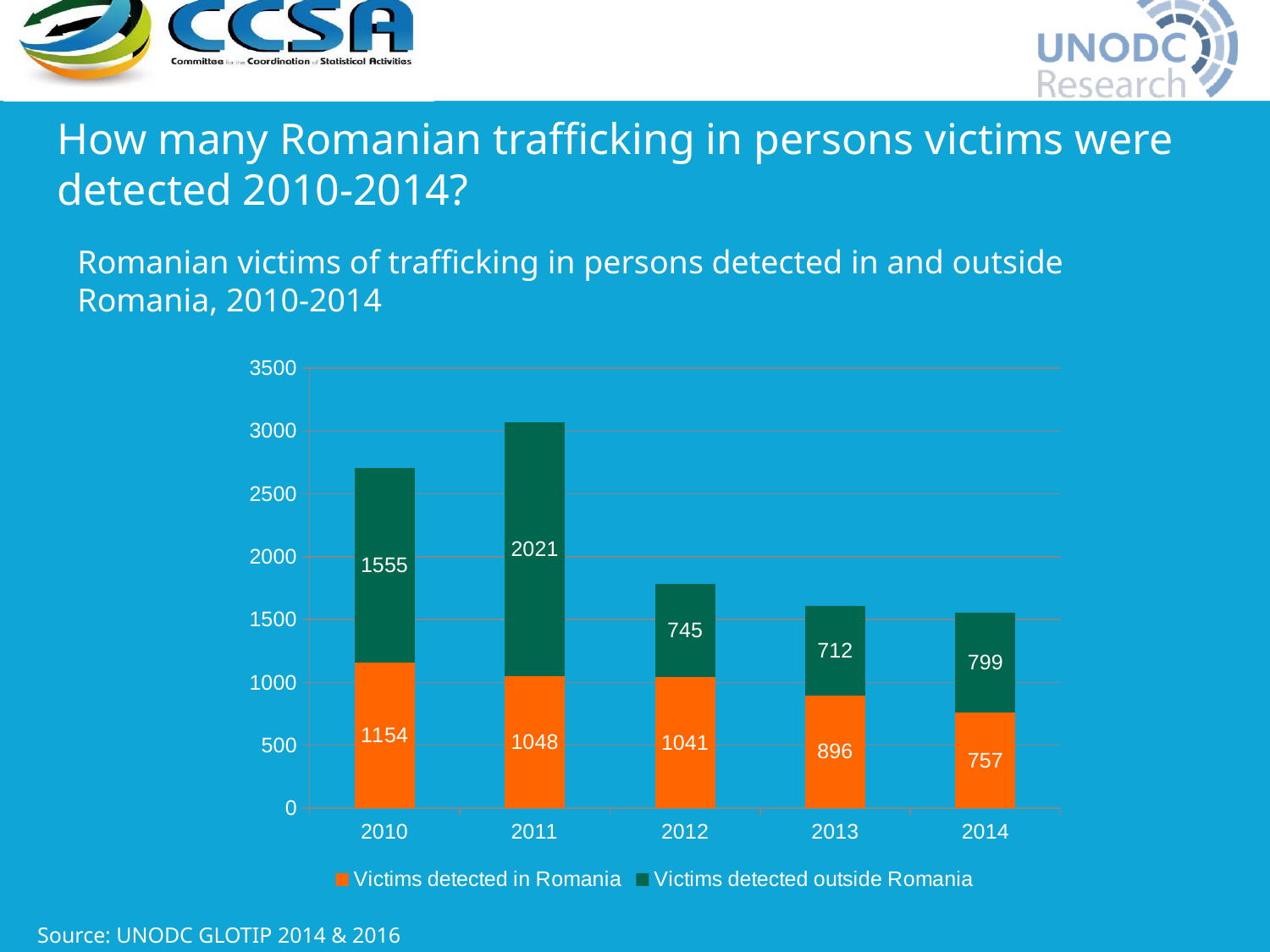
Which year has the highest number of victims detected outside Romania? 2011 How many victims were detected in Romania in 2010? 1154 Which year has the lowest number of victims detected in Romania? 2014 How many years are shown on the x axis? 5 How many series does the legend list? 2 How many victims were detected outside Romania in 2011? 2021 Is the total bar for 2011 greater or less than 3000? greater How many victims were detected in Romania in 2014? 757 Which is larger: victims detected in Romania in 2012 or victims detected outside Romania in 2012? Victims detected in Romania What is the difference between victims detected outside Romania in 2011 and in 2010? 466 What kind of chart is shown on the slide? Stacked bar chart What is the total number of Romanian victims detected in 2013 (in and outside Romania)? 1608